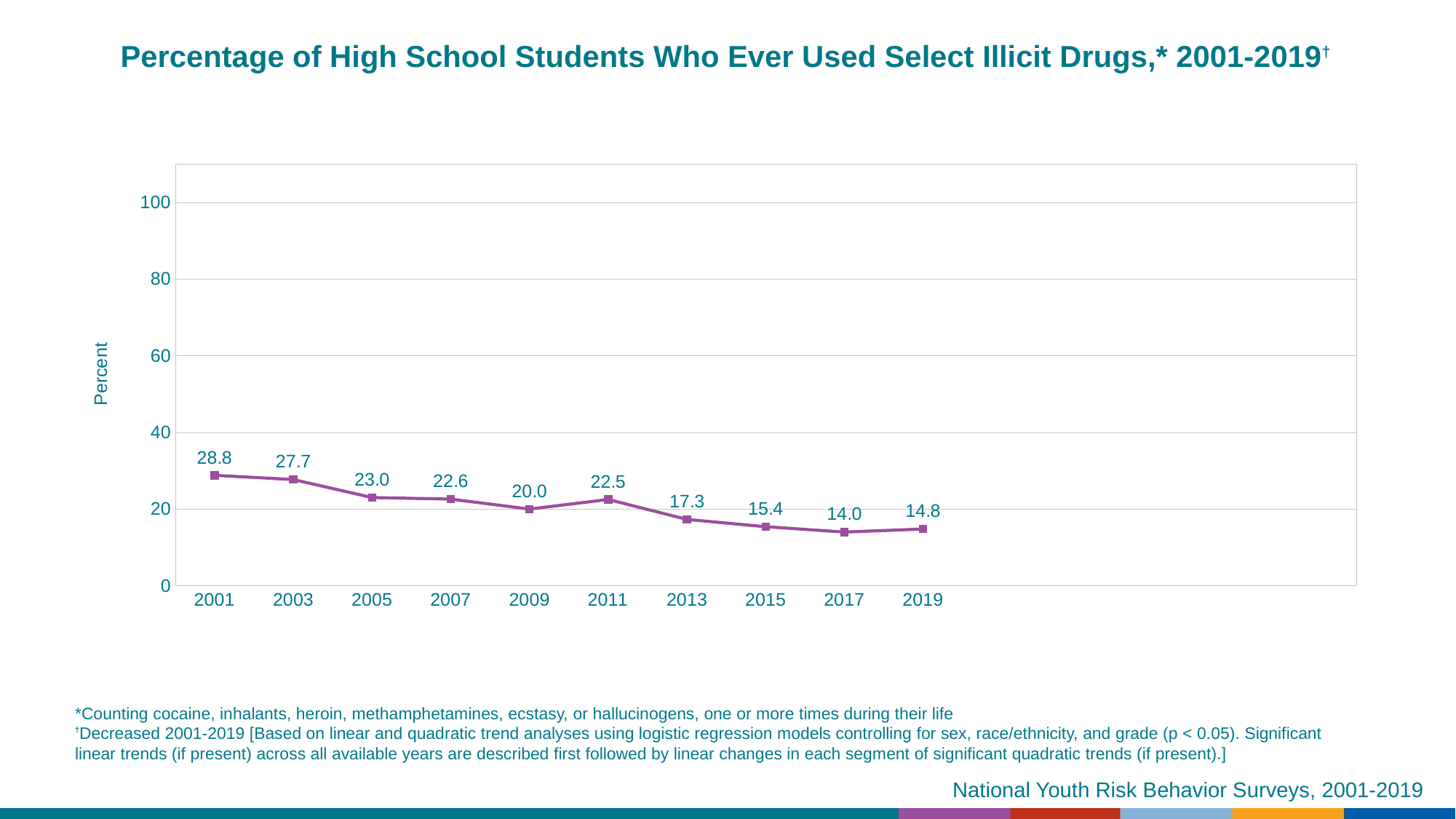
What is the difference between the 2009 value and the 2011 value? 2.5 Do the values generally rise or fall from 2001 to 2019? Fall What value is shown for 2011? 22.5 Is the value for 2005 greater or less than 20? greater Which year has the lowest percentage? 2017 What was the percentage of high school students who ever used select illicit drugs in 2019? 14.8 What was the percentage of high school students who ever used select illicit drugs in 2001? 28.8 How many years are plotted on the chart? 10 Which year has a larger value, 2013 or 2015? 2013 What is the difference between the 2001 value and the 2019 value? 14.0 Which year has the highest percentage? 2001 What kind of chart is shown on the slide? Line chart